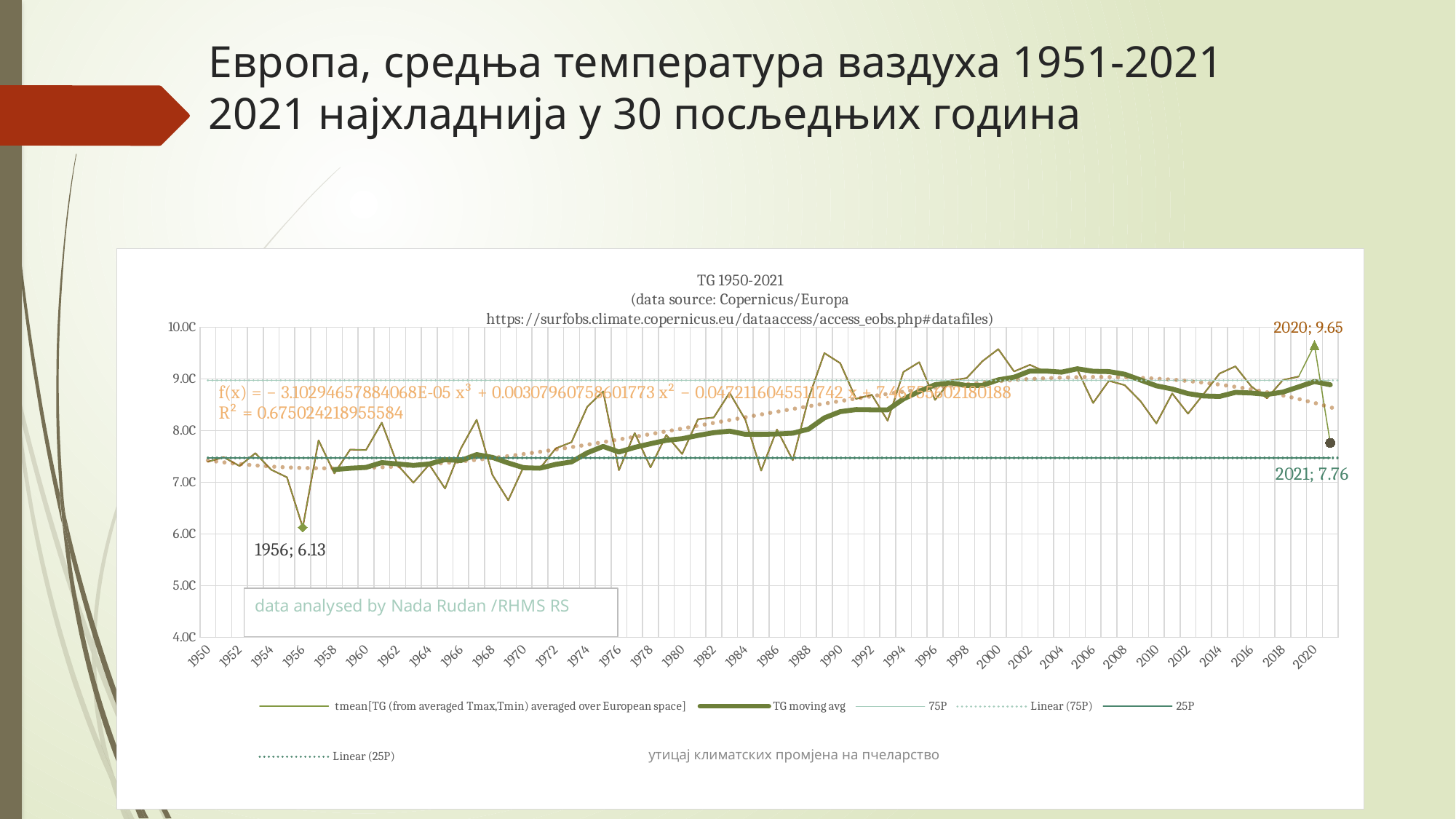
How many series does the legend list? 6 Which year has a higher tmean value, 2020 or 2021? 2020 What is the difference between the 2020 value and the 2021 value? 1.89 Does the TG moving avg line generally rise or fall from 1950 to 2021? rise Which year has the lowest tmean value in the chart? 1956 What is the difference between the 2020 value and the 1956 value? 3.52 Is the tmean value for 1969 greater or less than 7.0? less What is the tmean value for 2021? 7.76 What is the tmean value for 1956? 6.13 What kind of chart is shown on the slide? line chart What is the tmean value for 2020? 9.65 Is the tmean value for 1989 greater or less than 9.0? greater